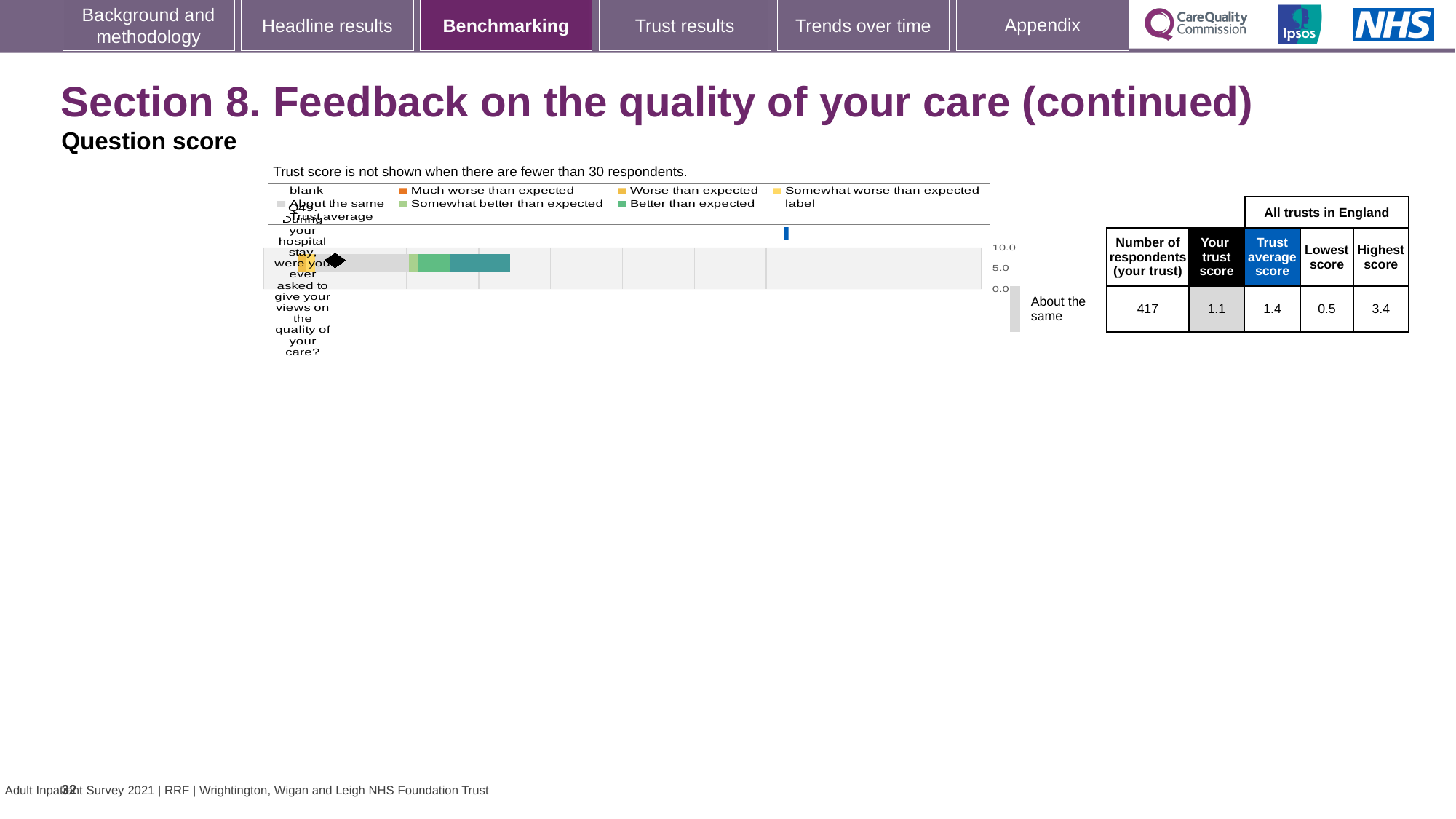
What is the number of respondents for your trust for Q49? 417 What is the highest score for Q49 among all trusts in England? 3.4 What is the lowest score for Q49 among all trusts in England? 0.5 Which is larger for Q49: your trust score or the trust average score? Trust average score What is the trust average score for Q49 across all trusts in England? 1.4 How is your trust's Q49 result categorised relative to expectations, according to the label next to the chart? About the same What is the difference between the trust average score and your trust score for Q49? 0.3 What kind of chart is used to show the Q49 benchmarking result on this slide? bar chart What is your trust score for Q49? 1.1 How many questions are plotted in the benchmarking chart on this slide? 1 Which legend entry in the benchmarking chart is shown in orange? Much worse than expected What is the difference between the highest and lowest scores for Q49 among all trusts in England? 2.9